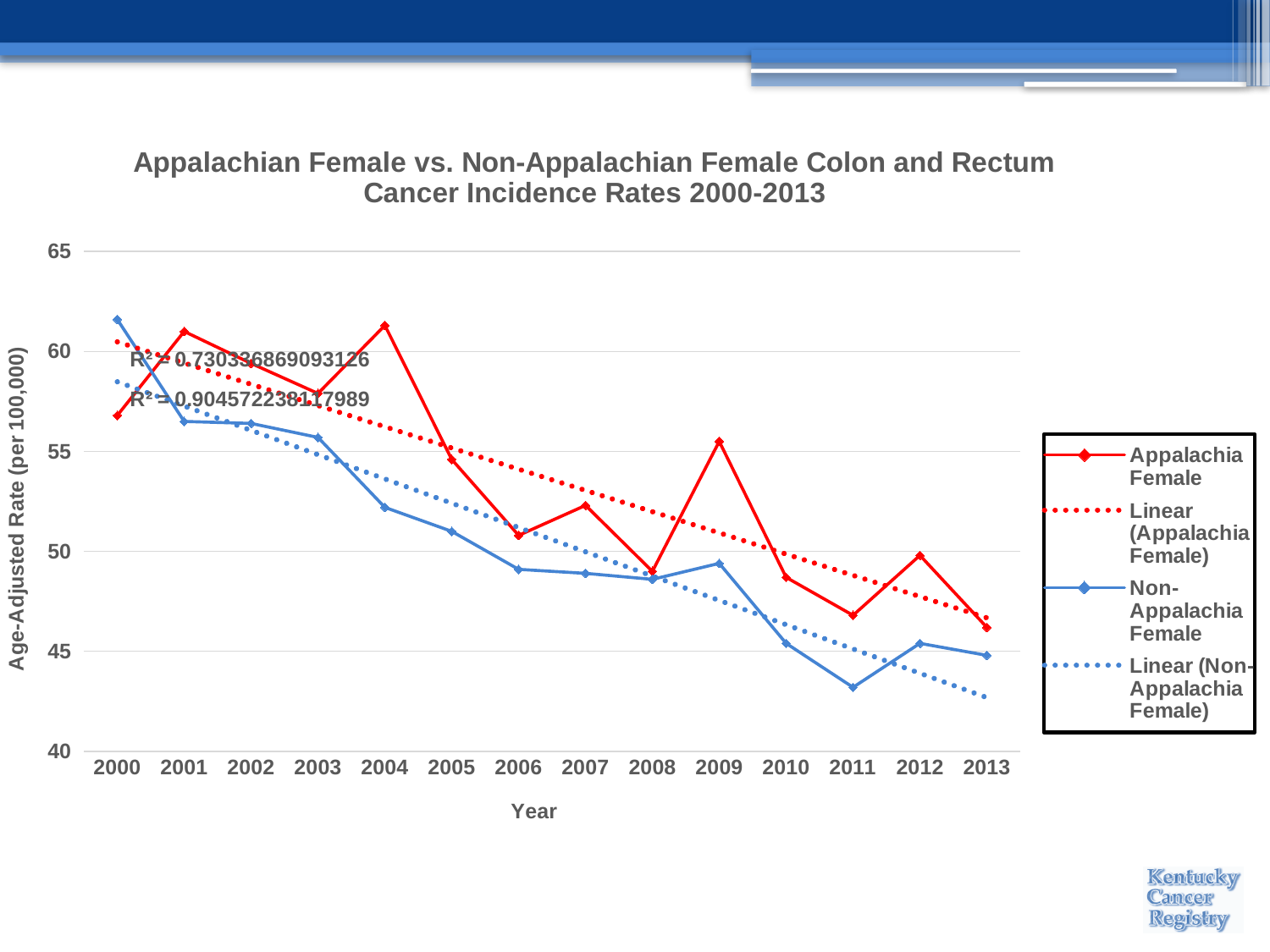
How many entries does the legend list? 4 Is the Non-Appalachia Female value for 2000 greater or less than 60? greater In 2009, which series has the higher value, Appalachia Female or Non-Appalachia Female? Appalachia Female In 2000, which series has the higher value, Appalachia Female or Non-Appalachia Female? Non-Appalachia Female Is the Appalachia Female value for 2004 greater or less than 60? greater Do the Appalachia Female incidence rates generally rise or fall from 2000 to 2013? fall Is the Non-Appalachia Female value for 2011 greater or less than 45? less How many years are plotted along the x axis? 14 In which year is the Non-Appalachia Female rate lowest? 2011 What is the title of the y axis? Age-Adjusted Rate (per 100,000) What kind of chart is shown on the slide? line chart